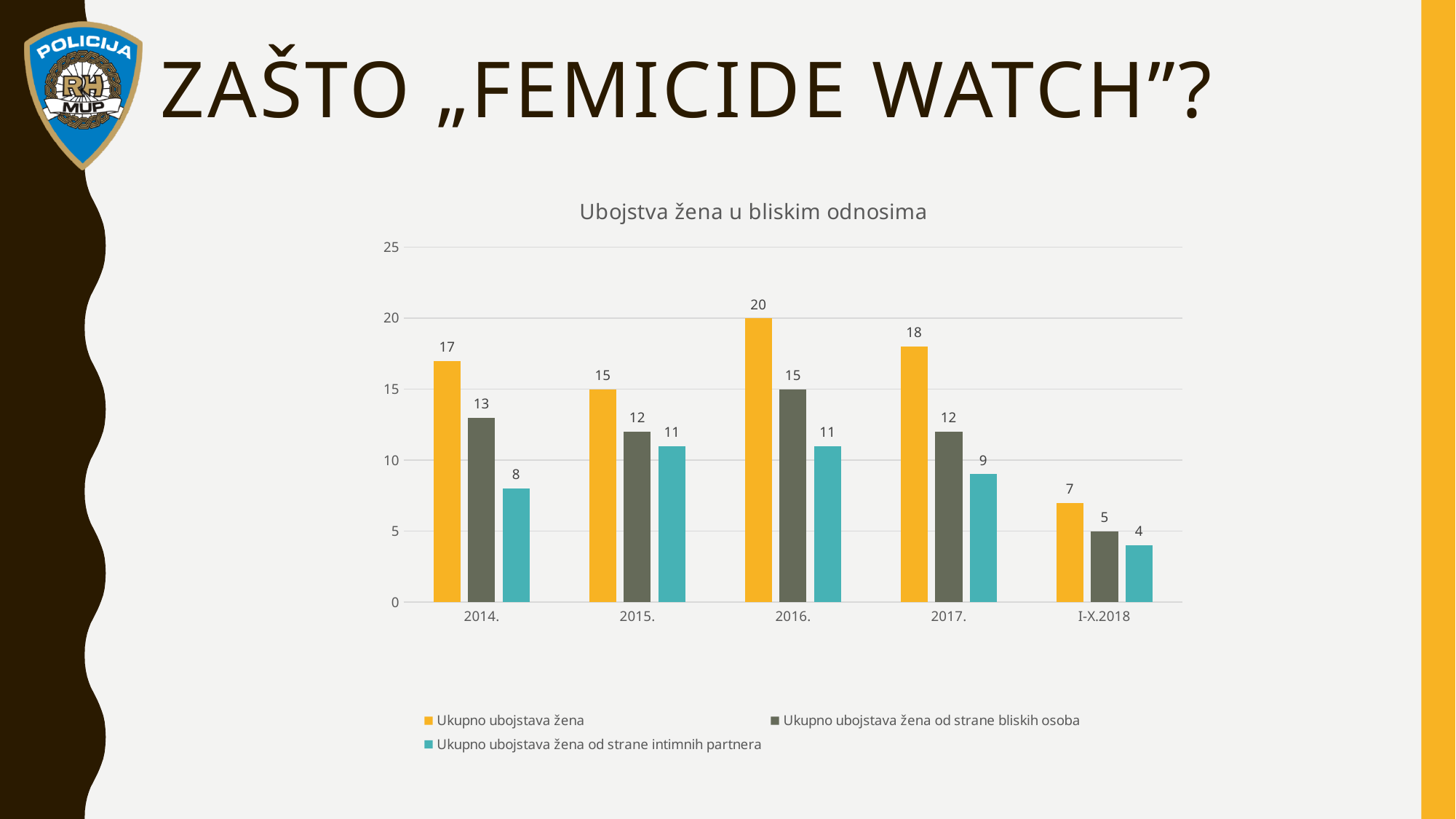
How many series does the legend list? 3 Which is larger: "Ukupno ubojstava žena od strane intimnih partnera" in 2015. or in 2017.? 2015. What is the value of "Ukupno ubojstava žena od strane bliskih osoba" for I-X.2018? 5 What is the difference between "Ukupno ubojstava žena" and "Ukupno ubojstava žena od strane bliskih osoba" in 2017.? 6 What is the value of "Ukupno ubojstava žena od strane intimnih partnera" for 2014.? 8 How many categories are shown on the x axis? 5 What kind of chart is shown on the slide? Bar chart What is the title of the chart? Ubojstva žena u bliskim odnosima In which year is "Ukupno ubojstava žena" highest? 2016. What is the value of "Ukupno ubojstava žena" for 2016.? 20 Which colour represents "Ukupno ubojstava žena" in the chart? Yellow/orange Which category has the lowest value for "Ukupno ubojstava žena od strane intimnih partnera"? I-X.2018